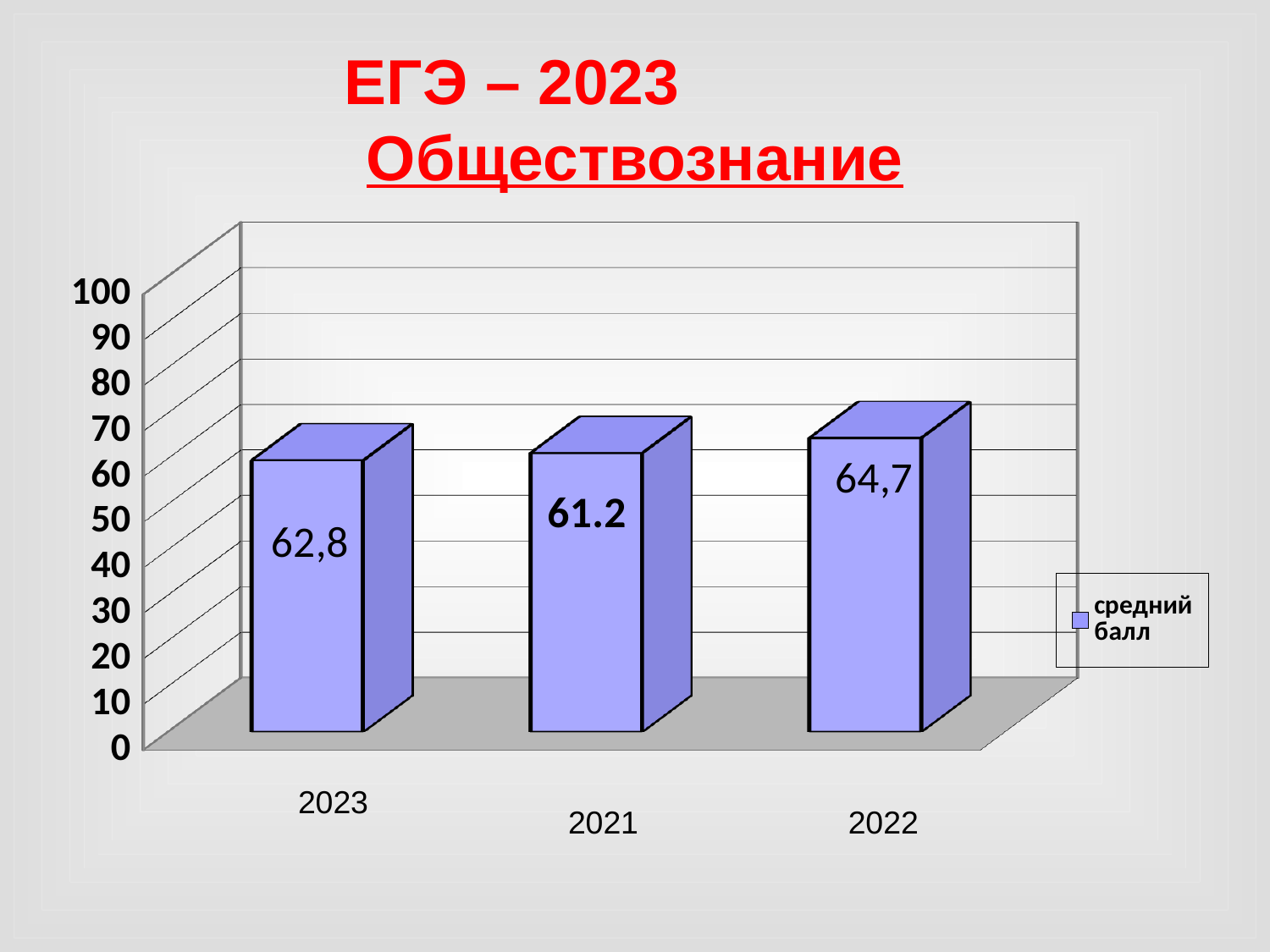
What is the average score (средний балл) shown for 2023? 62,8 What is the average score shown for 2022? 64,7 How many bars (years) are shown in the chart? 3 Which year has the highest average score? 2022 What is the average score shown for 2021? 61.2 Is the value for 2021 greater or less than 70? less What kind of chart is shown on the slide? bar chart How many series does the legend list? 1 Which is larger, the average score for 2022 or for 2023? 2022 What is the name of the series shown in the legend? средний балл Is the value for 2022 greater or less than 60? greater